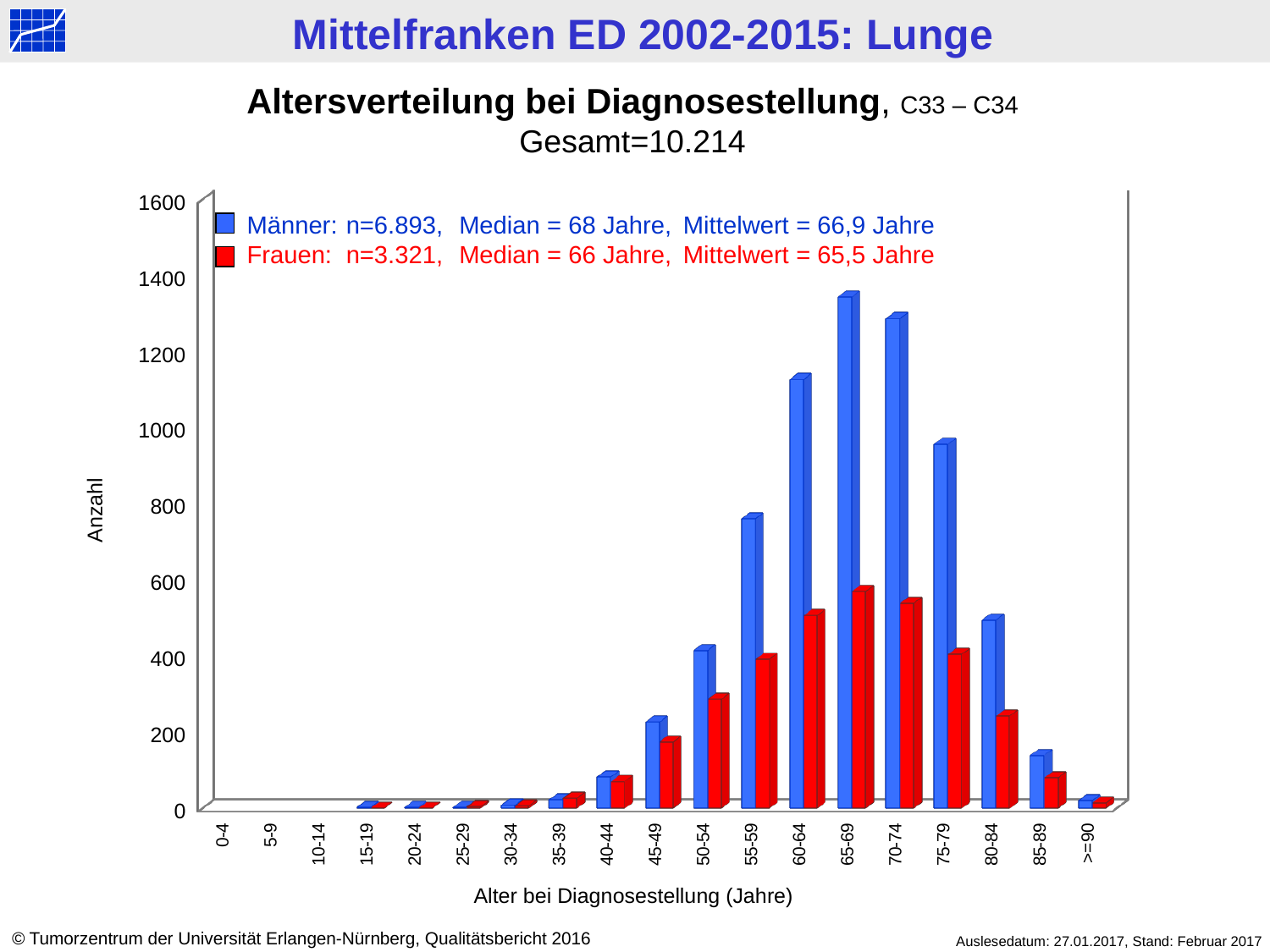
In the 65-69 age group, which series has the larger value, Männer or Frauen? Männer Do the values for Männer rise or fall from the 35-39 age group to the 65-69 age group? rise For Männer, which age group has the larger value, 60-64 or 70-74? 70-74 What kind of chart is shown on the slide? bar chart How many series does the legend list? 2 Is the value for Männer in the 80-84 age group greater or less than 400? greater Is the value for Männer in the 65-69 age group greater or less than 1200? greater According to the legend, what is n for Frauen? 3.321 How many age groups are shown on the x axis? 19 Is the value for Frauen in the 65-69 age group greater or less than 400? greater Which age group has the highest value for Männer? 65-69